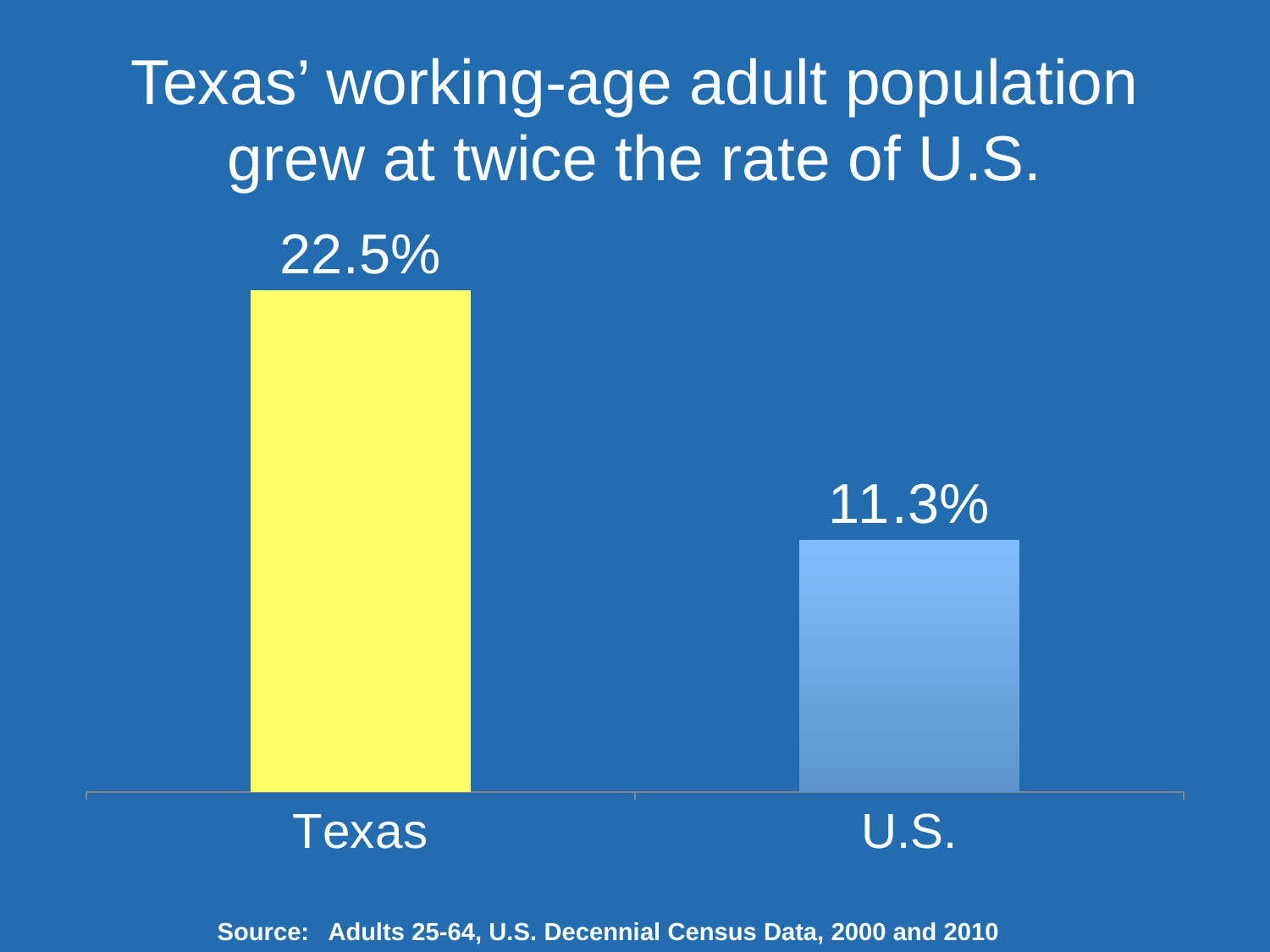
Which category has the lowest value? U.S. What is the difference between the Texas value and the U.S. value? 11.2% What colour is the bar for Texas? Yellow What is the value shown for Texas? 22.5% What is the title of the slide? Texas' working-age adult population grew at twice the rate of U.S. Which is larger, the value for Texas or the value for U.S.? Texas How many categories are shown in the chart? 2 What is the value shown for U.S.? 11.3% What kind of chart is shown on the slide? Bar chart Which category has the highest value? Texas